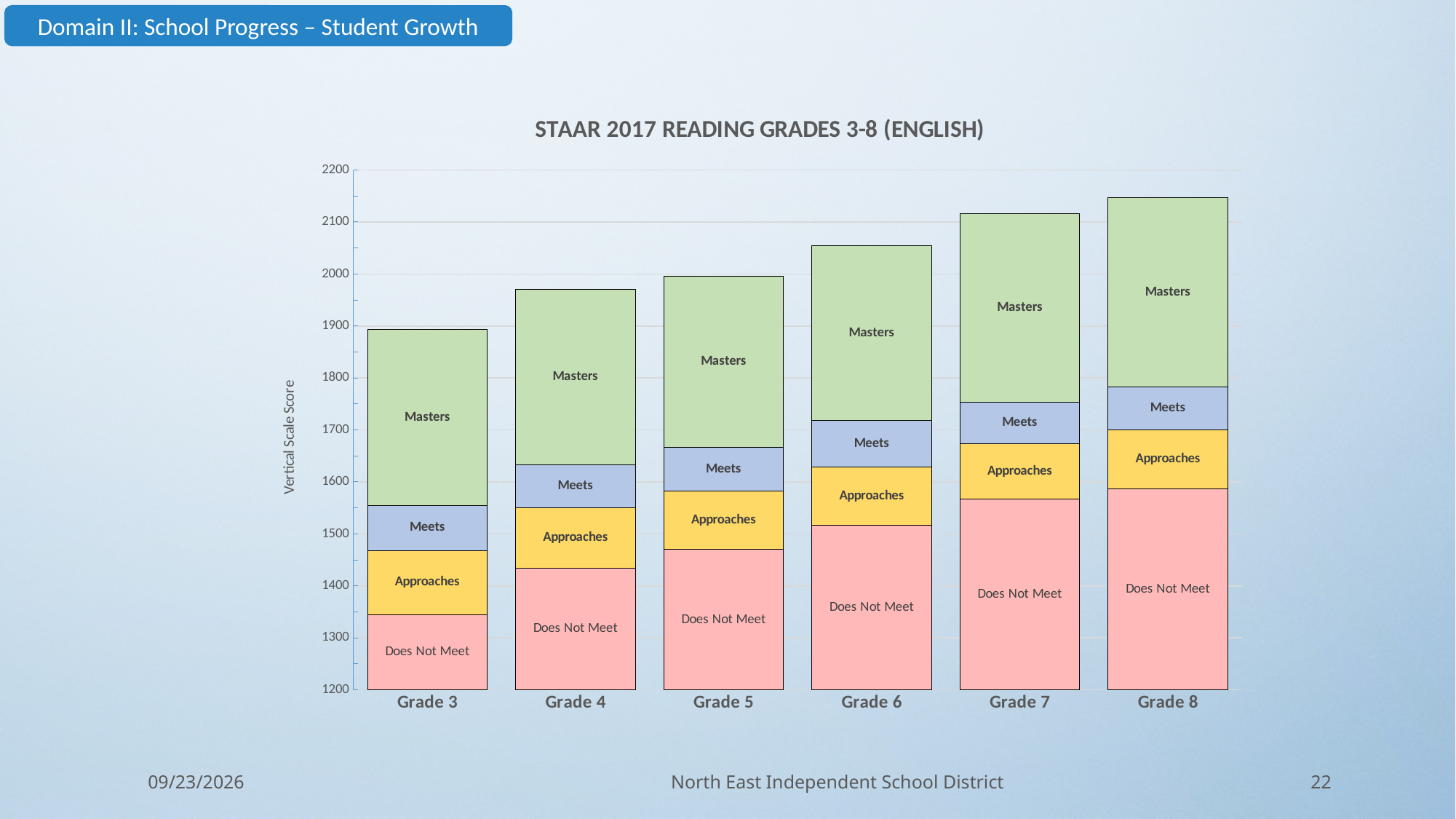
Which grade has the lowest top of its stacked bar? Grade 3 Is the top of the Grade 8 bar greater or less than 2100? greater Is the top of the Does Not Meet segment for Grade 3 greater or less than 1400? less Do the tops of the stacked bars rise or fall from Grade 3 to Grade 8? rise How many grade levels are shown on the x axis of the chart? 6 What kind of chart is shown on the slide? bar chart Which grade has the highest top of its stacked bar? Grade 8 Is the top of the Grade 4 bar greater or less than 2000? less Which bar reaches higher, Grade 5 or Grade 7? Grade 7 What is the title of the chart? STAAR 2017 READING GRADES 3-8 (ENGLISH) What is the label on the vertical axis of the chart? Vertical Scale Score